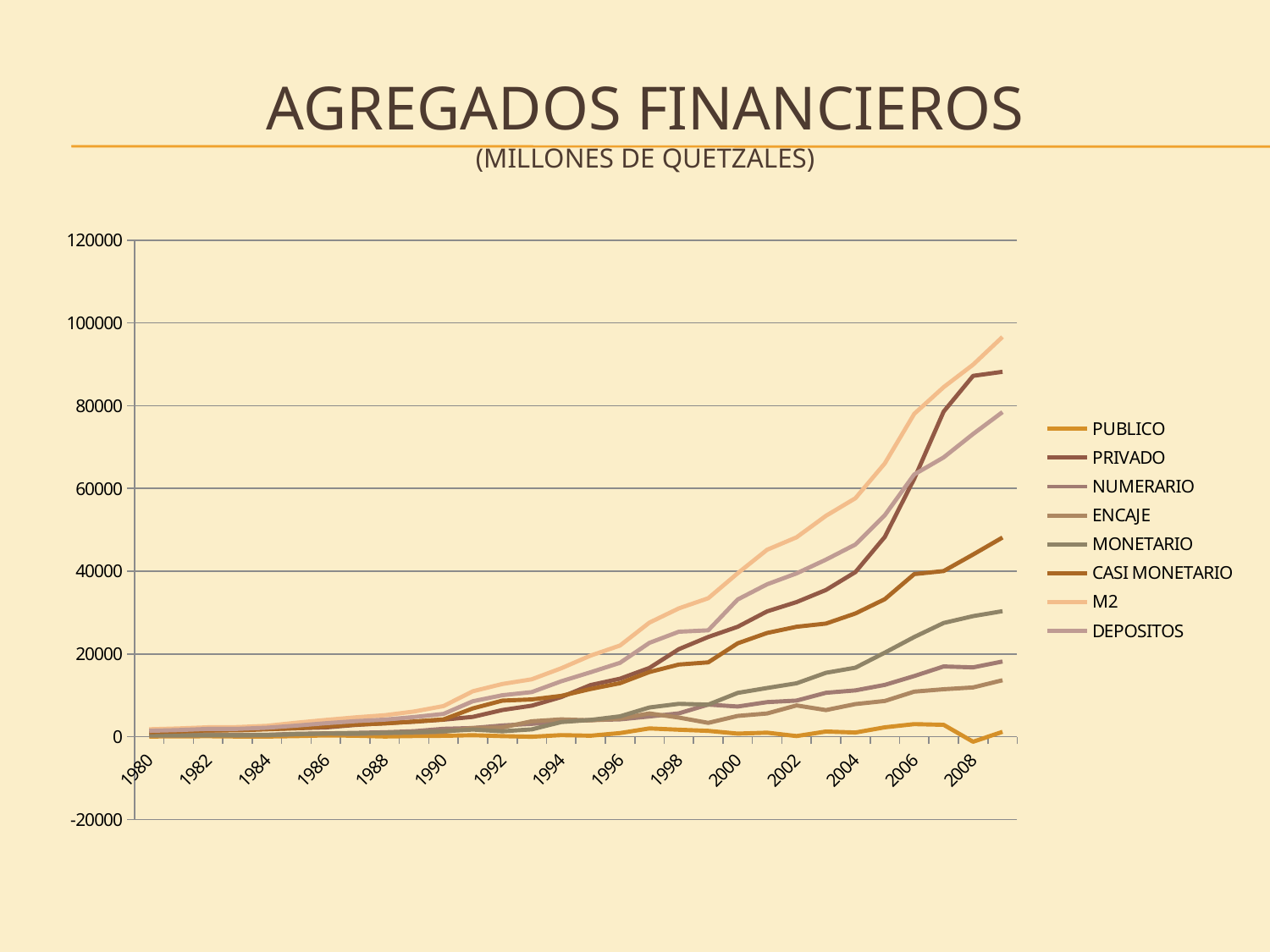
What is the title of the chart? AGREGADOS FINANCIEROS (MILLONES DE QUETZALES) Is the value for M2 in 2008 greater or less than 80000? greater Which series has the lowest value at the right end of the chart (2009)? PUBLICO In 2008, which is larger: CASI MONETARIO or MONETARIO? CASI MONETARIO Does the M2 series generally rise or fall from 1980 to 2009? rise What kind of chart is shown on the slide? line chart Is the value for CASI MONETARIO in 2008 greater or less than 40000? greater Is the value for DEPOSITOS in 2008 greater or less than 80000? less How many series does the legend list? 8 In 2008, which is larger: M2 or DEPOSITOS? M2 Which series has the highest value at the right end of the chart (2009)? M2